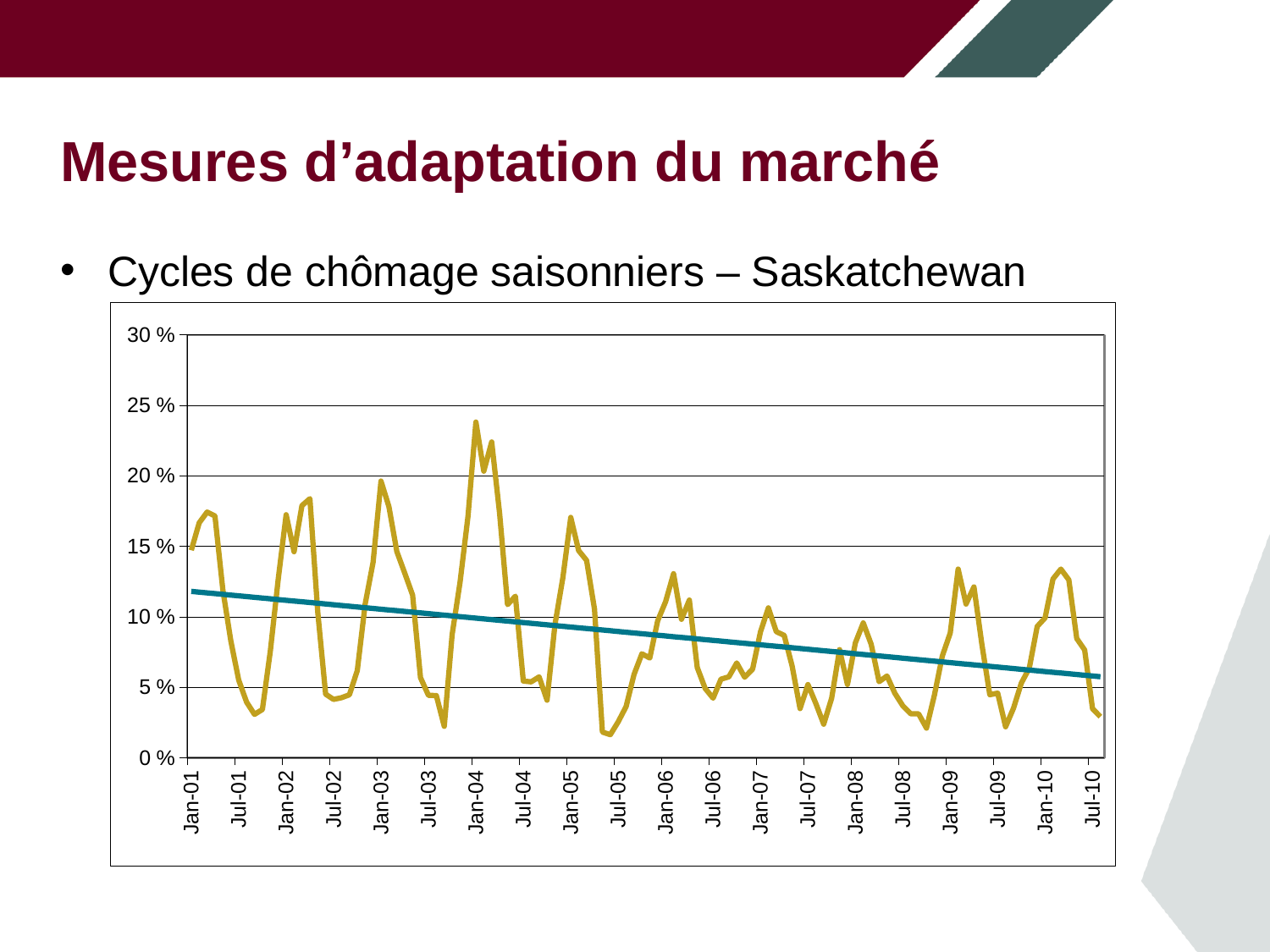
Near which x-axis label does the yellow line reach its highest peak? Jan-04 Is the trend line at Jan-01 greater or less than 10 %? greater Does the straight trend line rise or fall from Jan-01 to Jul-10? fall How many labels are shown on the x axis? 20 Is the highest peak of the yellow line greater or less than 20 %? greater What kind of chart is shown on the slide? line chart What is the highest value shown on the y axis? 30 % Is the value of the yellow line at Jul-05 greater or less than 5 %? less What region does the chart's seasonal unemployment cycle refer to, according to the bullet text? Saskatchewan Which is larger: the peak of the yellow line near Jan-04 or the peak near Jan-10? Jan-04